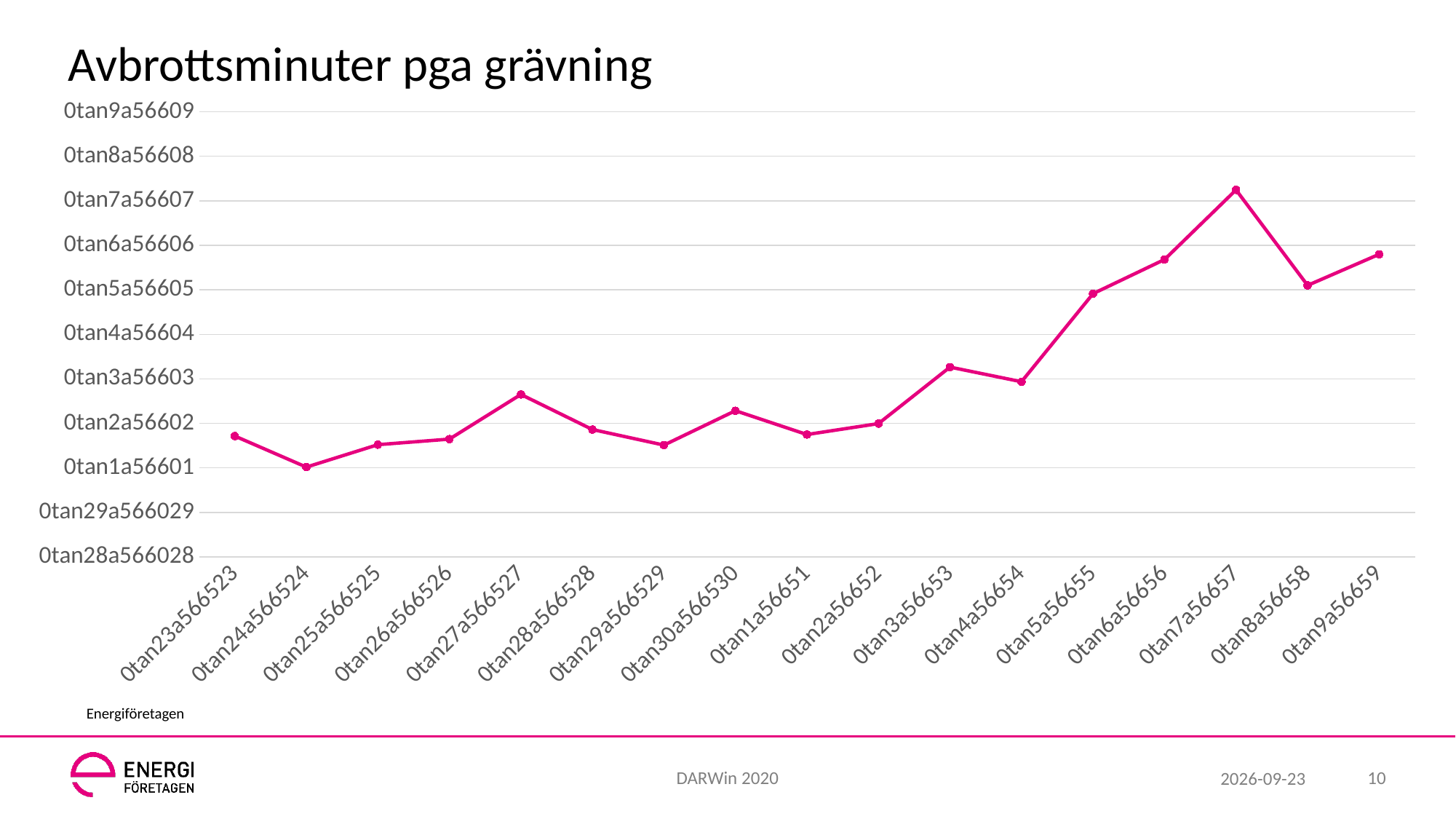
Which category has the lowest value? 0tan24a566524 How many data points are plotted on the line? 17 Which is larger, the value for 0tan27a566527 or the value for 0tan29a566529? 0tan27a566527 What kind of chart is shown on the slide? line chart What is the title of the chart? Avbrottsminuter pga grävning What colour is the plotted line? pink What is the label of the first category on the x axis? 0tan23a566523 Which is larger, the value for 0tan7a56657 or the value for 0tan8a56658? 0tan7a56657 Does the value rise or fall between 0tan7a56657 and 0tan8a56658? fall Do the values generally rise or fall from left to right along the x axis? rise Which category has the highest value? 0tan7a56657 Which is larger, the value for 0tan5a56655 or the value for 0tan23a566523? 0tan5a56655